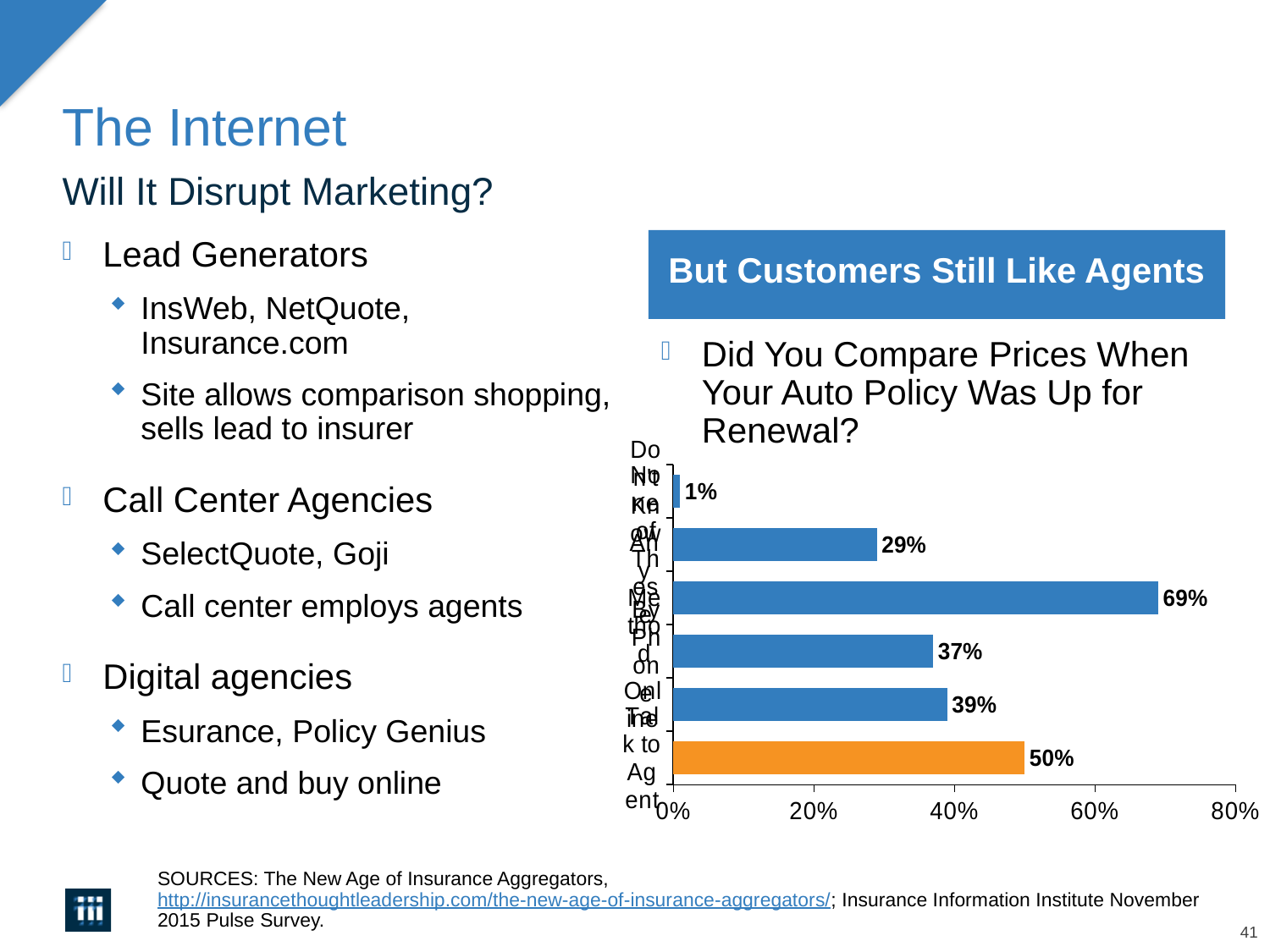
Which is larger, the fourth bar from the top (37%) or the fifth bar from the top (39%)? 39% What is the value of the topmost bar in the chart? 1% What is the maximum value shown on the horizontal axis of the chart? 80% What type of chart is shown on the slide? bar chart What is the value of the orange bar at the bottom of the chart? 50% What is the difference between the largest bar (69%) and the orange bar (50%)? 19% How many bars are plotted in the chart? 6 Is the value of the second bar from the top greater or less than 20%? greater What colour is the bottom bar in the chart, which differs from the others? orange What is the highest value shown in the chart? 69% What is the value of the third bar from the top? 69% What is the lowest value shown in the chart? 1%